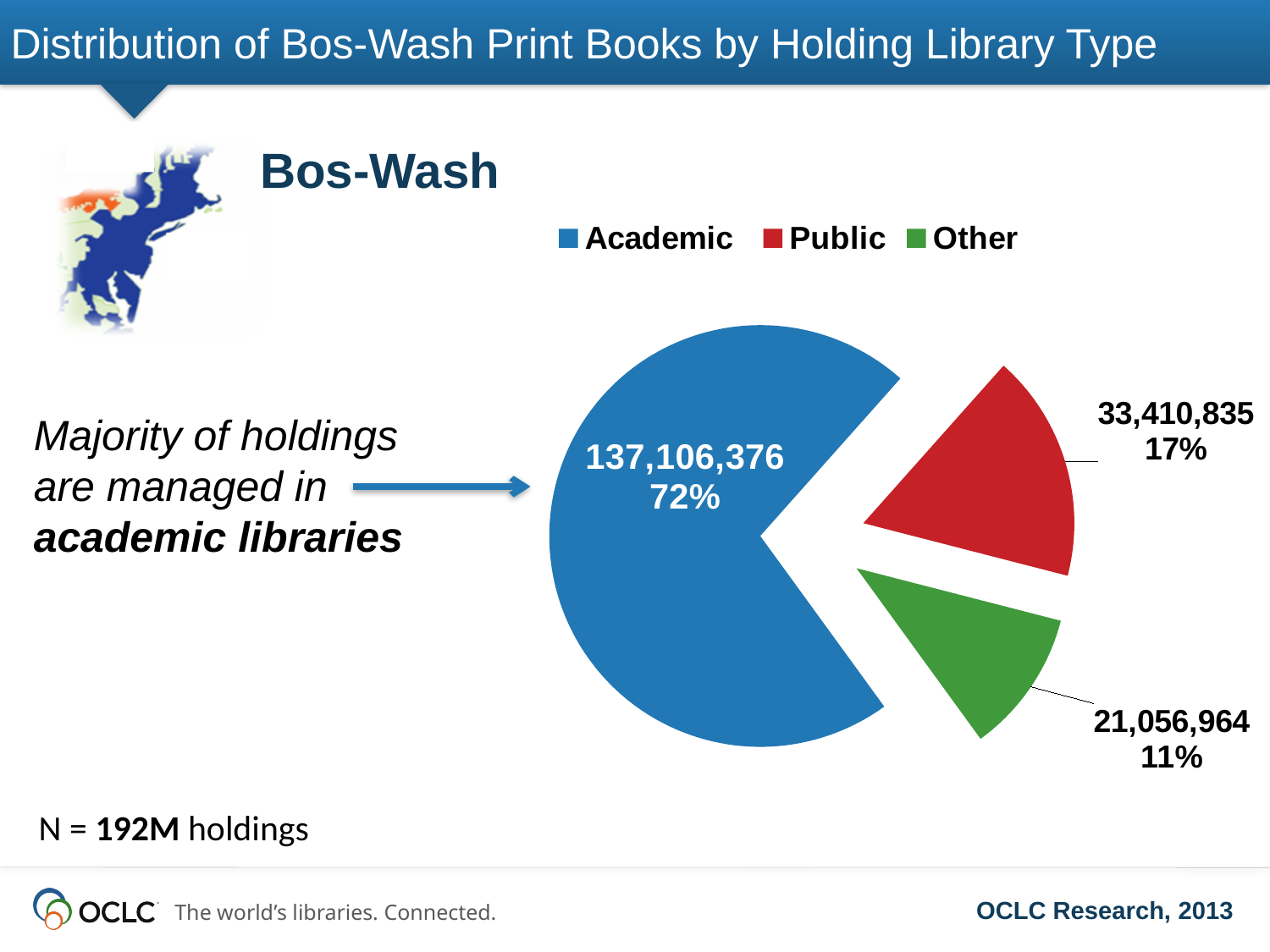
What share of the pie does the Other slice represent? 11% What share of the pie does the Academic slice represent? 72% Which library type holds the fewest print books? Other Which colour represents Public libraries in the pie chart? red What is the difference in holdings between Public and Other libraries? 12,353,871 How many holdings are in Public libraries according to the pie chart? 33,410,835 How many slices does the pie chart have? 3 What share of the pie does the Public slice represent? 17% How many holdings are in Other libraries according to the pie chart? 21,056,964 What kind of chart is shown on the slide? pie chart How many holdings are in Academic libraries according to the pie chart? 137,106,376 Which library type holds the most print books? Academic